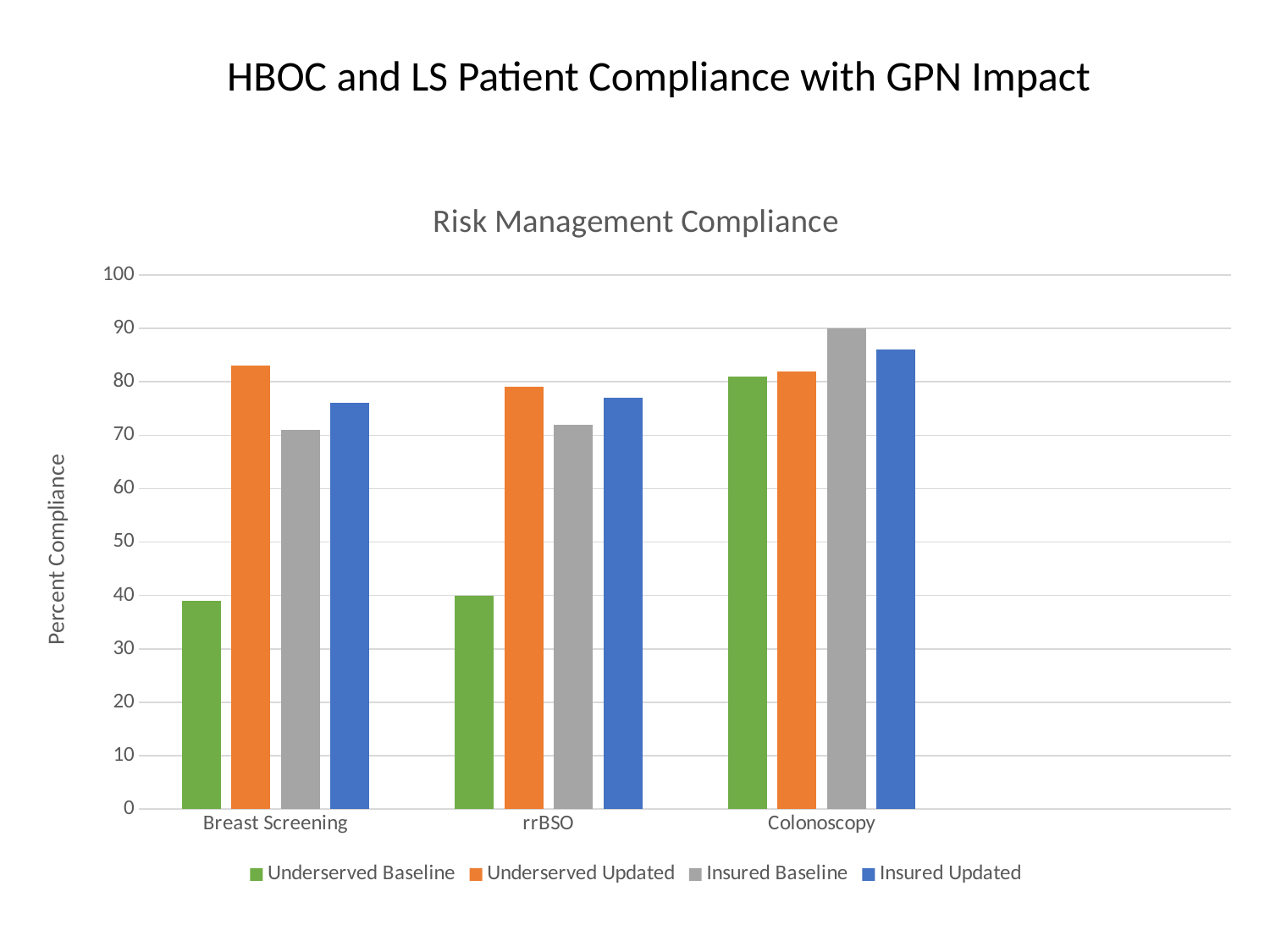
What type of chart is shown on the slide? bar chart How many categories are shown on the x axis of the chart? 3 How many series does the chart's legend list? 4 Which series has the highest value for Breast Screening? Underserved Updated Which is larger: the Underserved Baseline value for Colonoscopy or the Underserved Baseline value for rrBSO? Colonoscopy Is the Insured Updated value for Colonoscopy greater or less than 80? greater Is the Underserved Updated value for Breast Screening greater or less than 80? greater Is the Underserved Baseline value for Breast Screening greater or less than 50? less What is the title of the chart? Risk Management Compliance Which series has the lowest value for rrBSO? Underserved Baseline What is the label on the vertical axis of the chart? Percent Compliance Which category has the highest Insured Baseline value? Colonoscopy